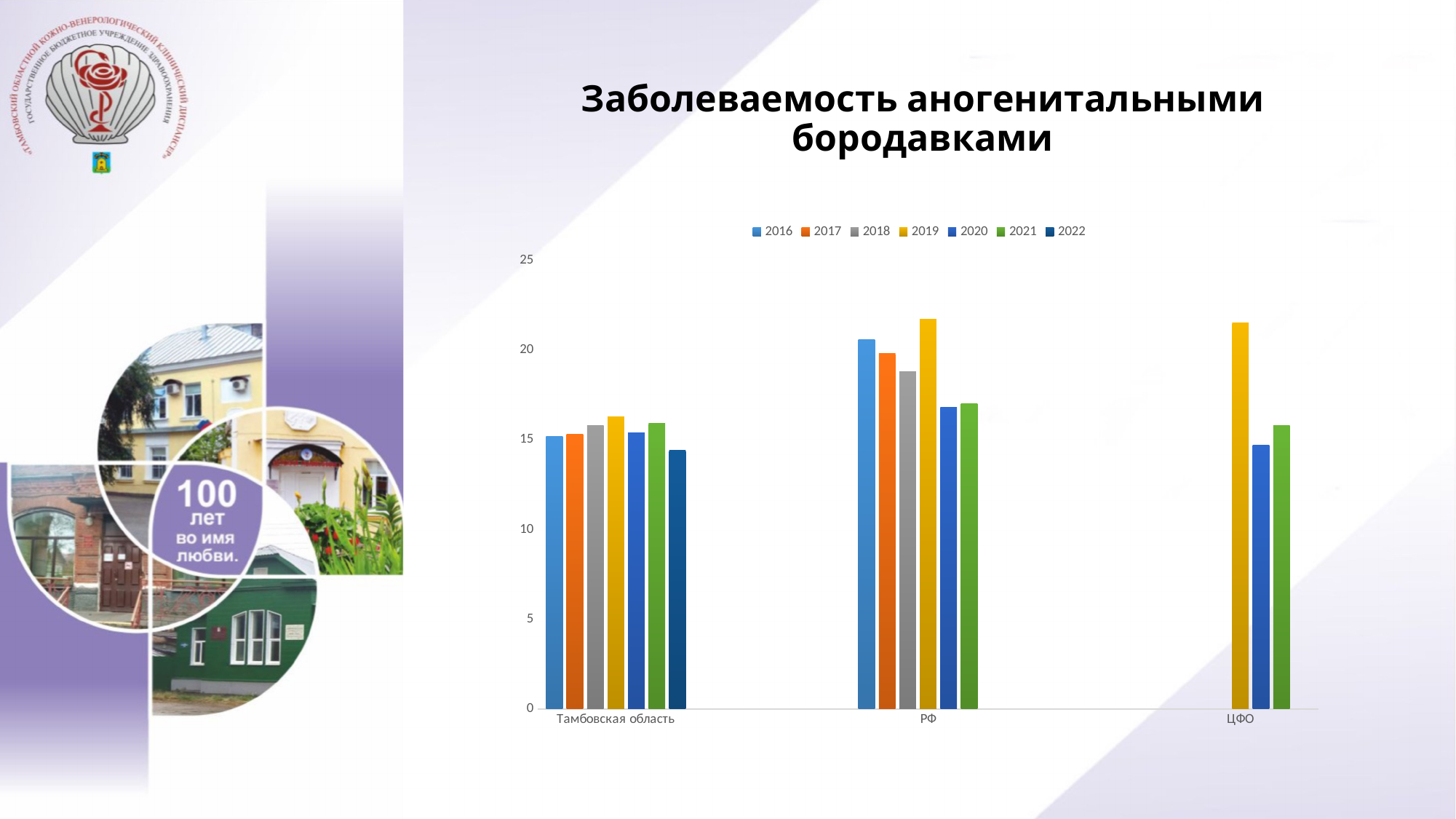
Which is larger, the 2019 value for РФ or the 2019 value for Тамбовская область? РФ Is the value for Тамбовская область in 2022 greater or less than 15? less Is the value for РФ in 2019 greater or less than 20? greater Which year has the highest value for РФ? 2019 Which years are listed in the legend? 2016, 2017, 2018, 2019, 2020, 2021, 2022 How many series does the legend list? 7 What kind of chart is shown on the slide? bar chart Is the value for РФ in 2020 greater or less than 15? greater How many categories are shown on the x axis? 3 What is the title of the chart? Заболеваемость аногенитальными бородавками Which year has the lowest value for Тамбовская область? 2022